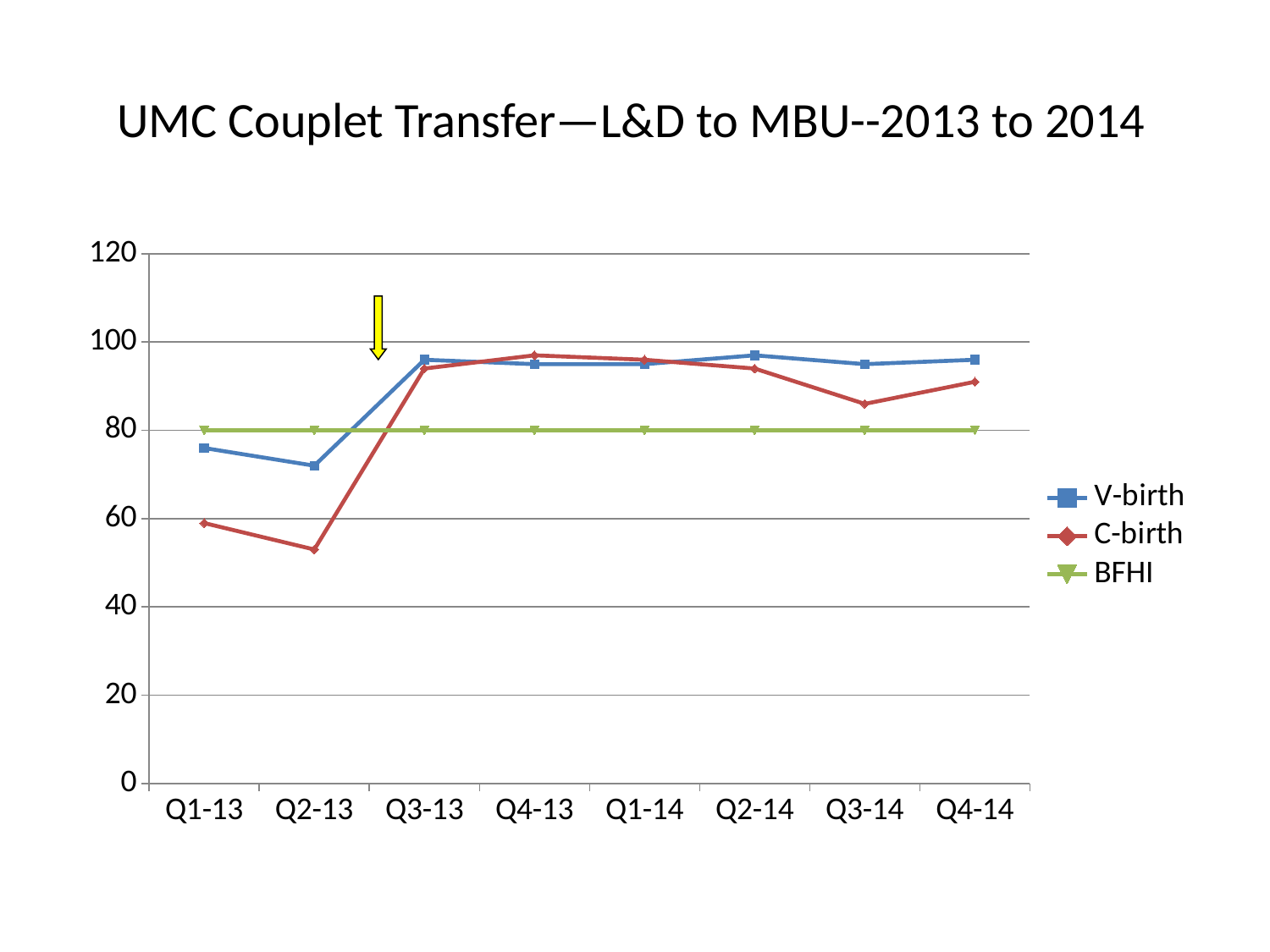
What is the title of the chart? UMC Couplet Transfer—L&D to MBU--2013 to 2014 In which quarter is the V-birth value lowest? Q2-13 At Q1-13, which series has the larger value, V-birth or C-birth? V-birth In which quarter is the C-birth value lowest? Q2-13 What kind of chart is shown on the slide? line chart How many series does the legend list? 3 Is the C-birth value for Q2-13 greater or less than 60? less Is the C-birth value for Q3-14 greater or less than 80? greater Does the C-birth line rise or fall from Q2-13 to Q3-13? rise Is the V-birth value for Q1-13 greater or less than 80? less What is the value of the BFHI line at Q1-14? 80 How many quarters are plotted along the x axis? 8